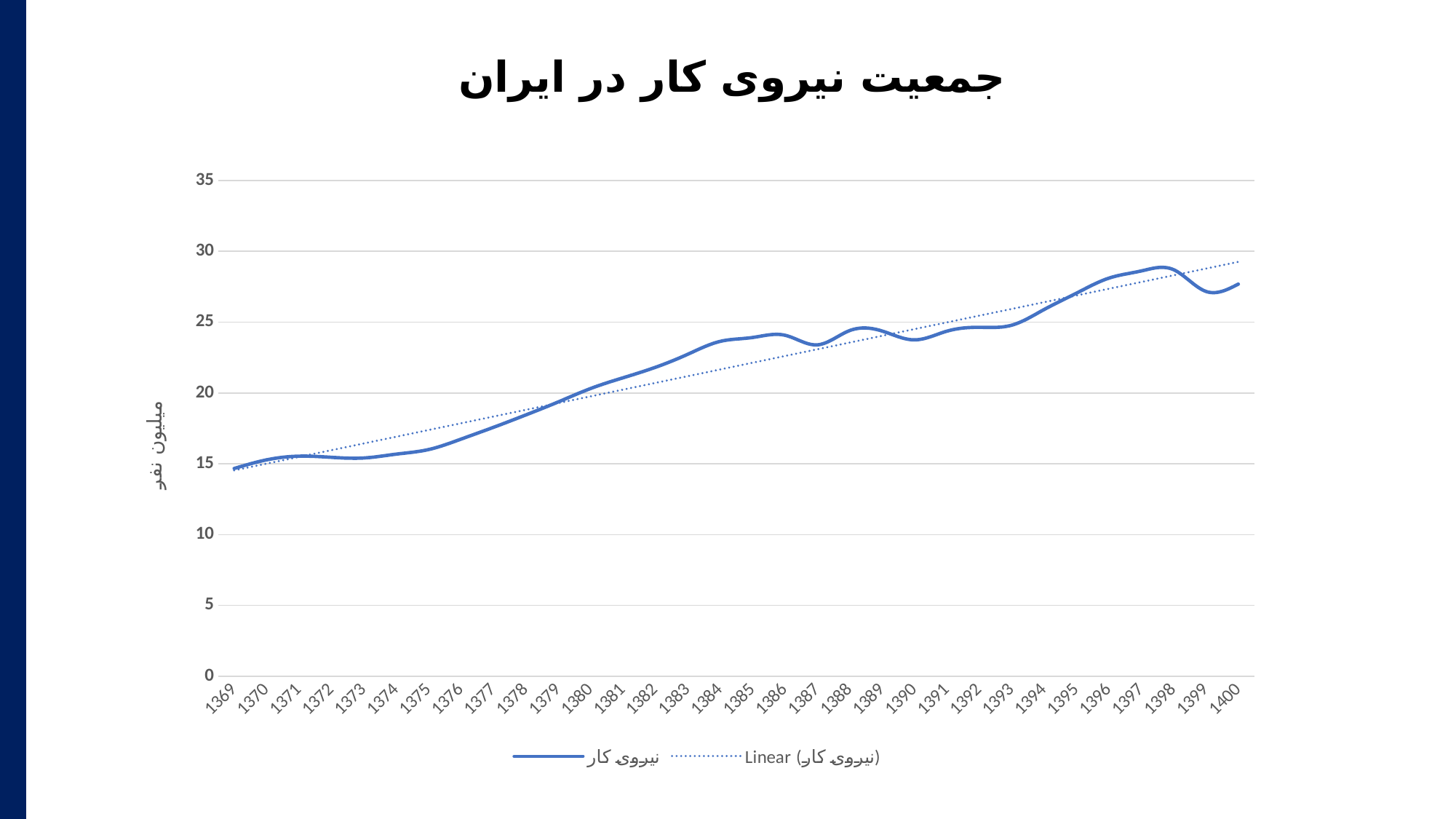
Is the value for نیروی کار in 1369 greater or less than 15? less Is the value for نیروی کار in 1398 greater or less than 30? less What is the title of the chart? جمعیت نیروی کار در ایران Overall, do the values for نیروی کار rise or fall from 1369 to 1400? rise How many years are plotted along the x axis? 32 Is the value for نیروی کار in 1384 greater or less than 20? greater Which year has the larger value for نیروی کار, 1398 or 1400? 1398 What is the label on the vertical axis? میلیون نفر What kind of chart is shown on the slide? line chart Which year has the highest value for نیروی کار? 1398 How many entries does the legend list? 2 Which year has the lowest value for نیروی کار? 1369